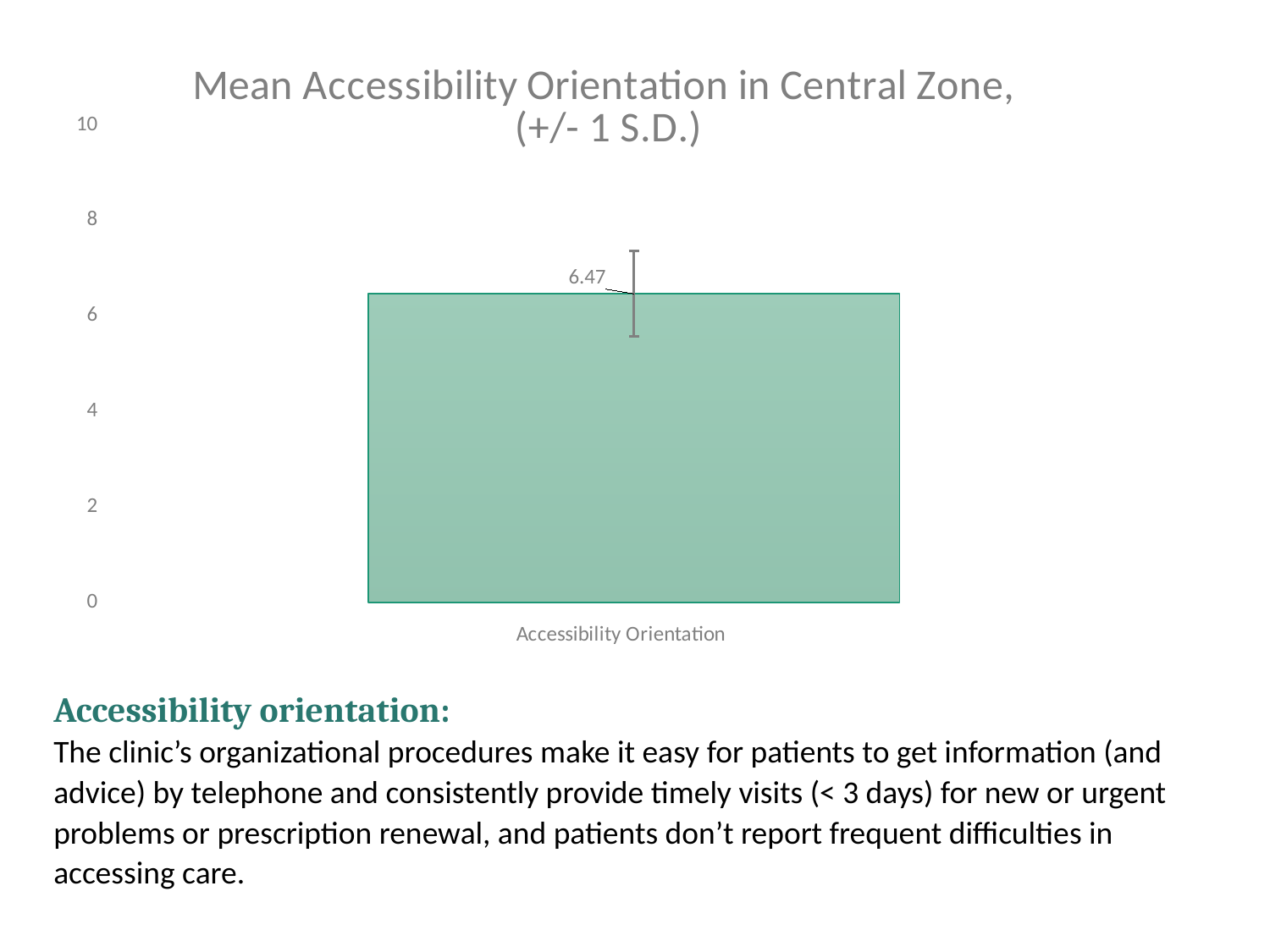
Is the value for Accessibility Orientation greater or less than 8? less What is the category label on the x axis of the chart? Accessibility Orientation Is the value for Accessibility Orientation greater or less than 6? greater How many bars are plotted in the chart? 1 What kind of chart is shown on the slide? bar chart What is the value shown for Accessibility Orientation? 6.47 What is the title of the chart? Mean Accessibility Orientation in Central Zone, (+/- 1 S.D.) What is the maximum value shown on the y axis of the chart? 10